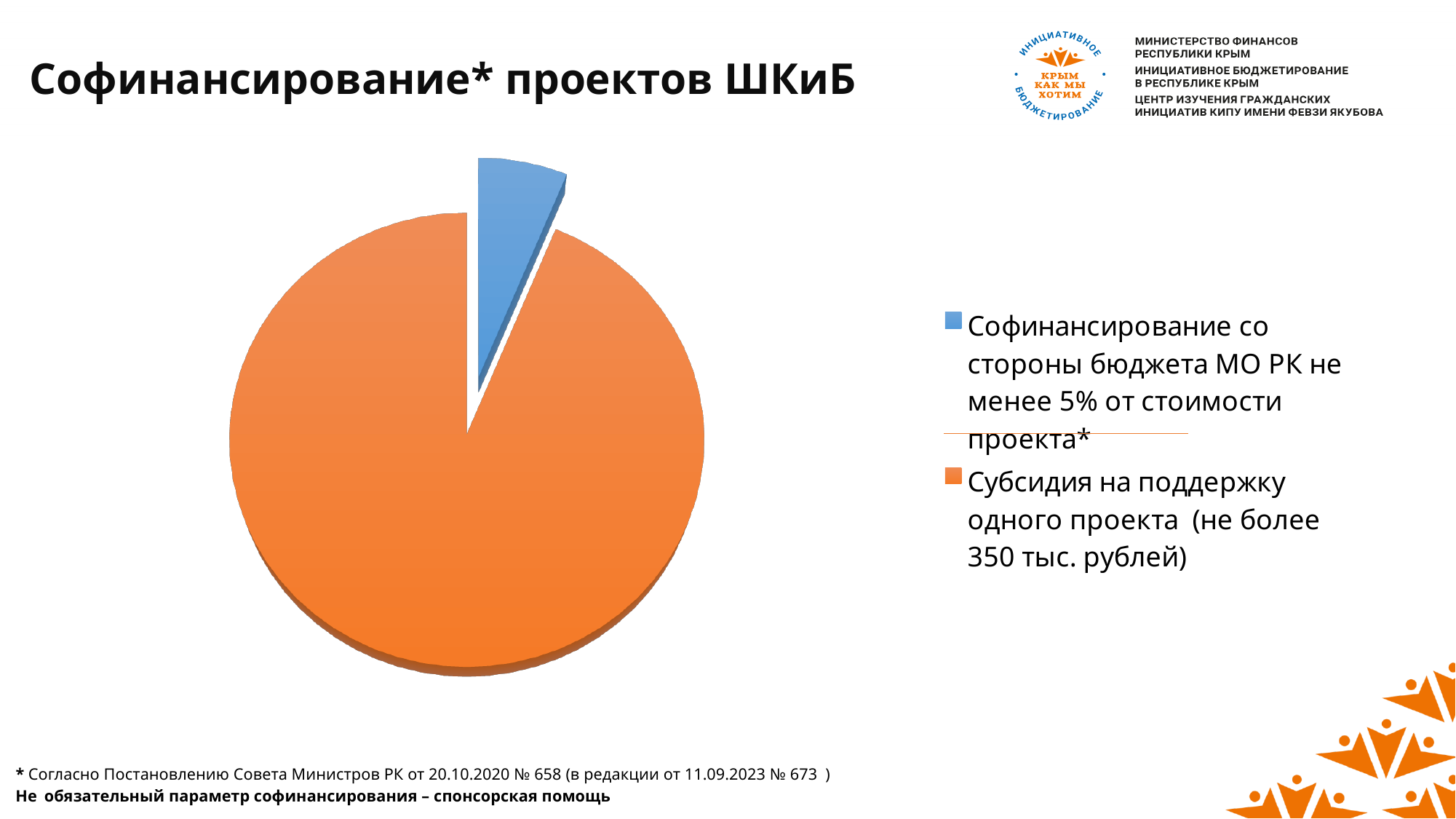
Which category takes up the smallest share of the pie chart? Софинансирование со стороны бюджета МО РК не менее 5% от стоимости проекта* What kind of chart is shown on the slide? Pie chart How many entries does the legend of the pie chart list? 2 How many slices does the pie chart have? 2 What colour is the slice for 'Субсидия на поддержку одного проекта' in the pie chart? Orange What is the title of the slide containing the pie chart? Софинансирование* проектов ШКиБ Which category takes up the largest share of the pie chart? Субсидия на поддержку одного проекта (не более 350 тыс. рублей) Which slice is larger: the one for 'Софинансирование со стороны бюджета МО РК' or the one for 'Субсидия на поддержку одного проекта'? Субсидия на поддержку одного проекта